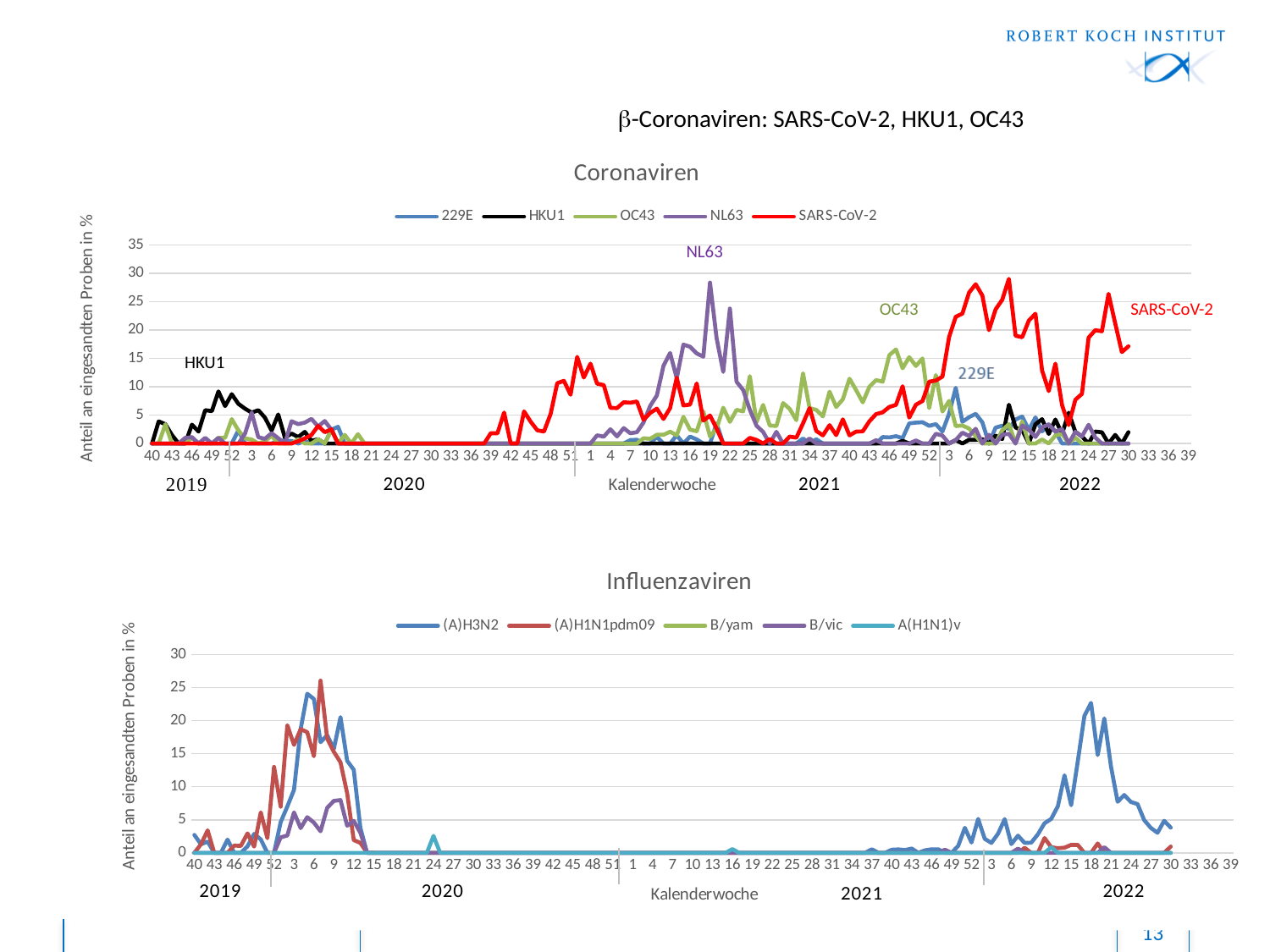
In the 'Coronaviren' chart, is the peak value of SARS-CoV-2 greater or less than 25? greater In the 'Coronaviren' chart, which series is drawn in red? SARS-CoV-2 What kind of chart is the 'Influenzaviren' chart? line chart How many series does the legend of the 'Coronaviren' chart list? 5 What kind of chart is the 'Coronaviren' chart? line chart In the 'Influenzaviren' chart, is the peak value of B/vic greater or less than 10? less In the 'Coronaviren' chart, is the peak value of NL63 greater or less than 25? greater How many series does the legend of the 'Influenzaviren' chart list? 5 What is the y-axis label of the 'Influenzaviren' chart? Anteil an eingesandten Proben in %